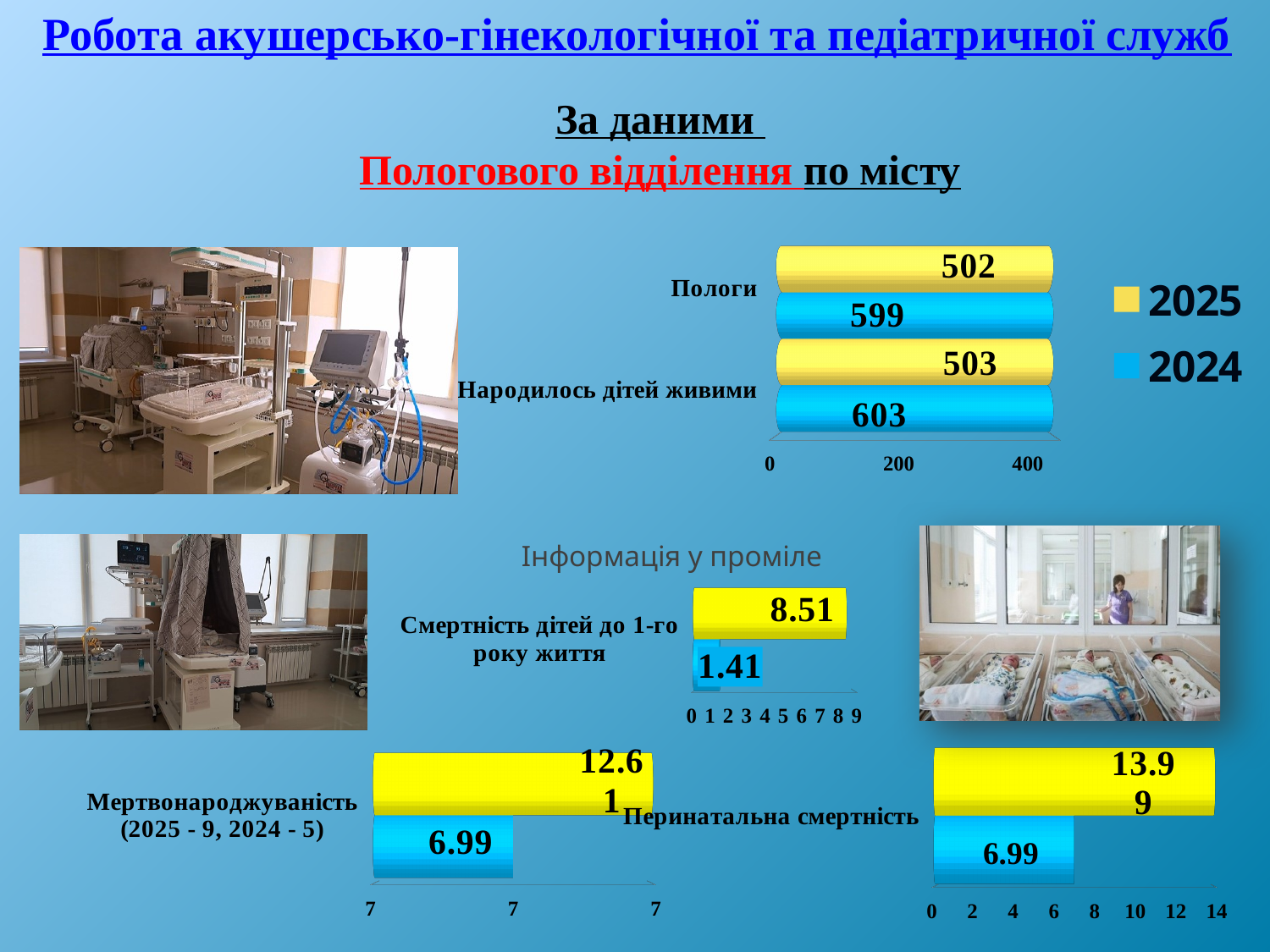
In the top-right chart, which year has the larger value for Пологи, 2024 or 2025? 2024 In the chart titled Мертвонароджуваність, what is the value of the blue (2024) bar? 6.99 What kind of chart is the top-right chart showing Пологи and Народилось дітей живими? bar chart In the chart titled Перинатальна смертність, what is the difference between the yellow (2025) and blue (2024) bars? 7 In the top-right chart, what is the value for Пологи in 2024? 599 How many series does the legend of the top-right chart list? 2 In the chart titled Перинатальна смертність, what is the value of the yellow (2025) bar? 13.99 In the chart titled Смертність дітей до 1-го року життя, what is the value of the blue (2024) bar? 1.41 In the top-right chart, what is the value for Народилось дітей живими in 2024? 603 In the top-right chart, what is the value for Пологи in 2025? 502 In the top-right chart, what is the difference between the 2024 and 2025 values for Народилось дітей живими? 100 In the chart titled Смертність дітей до 1-го року життя, what is the value of the yellow (2025) bar? 8.51